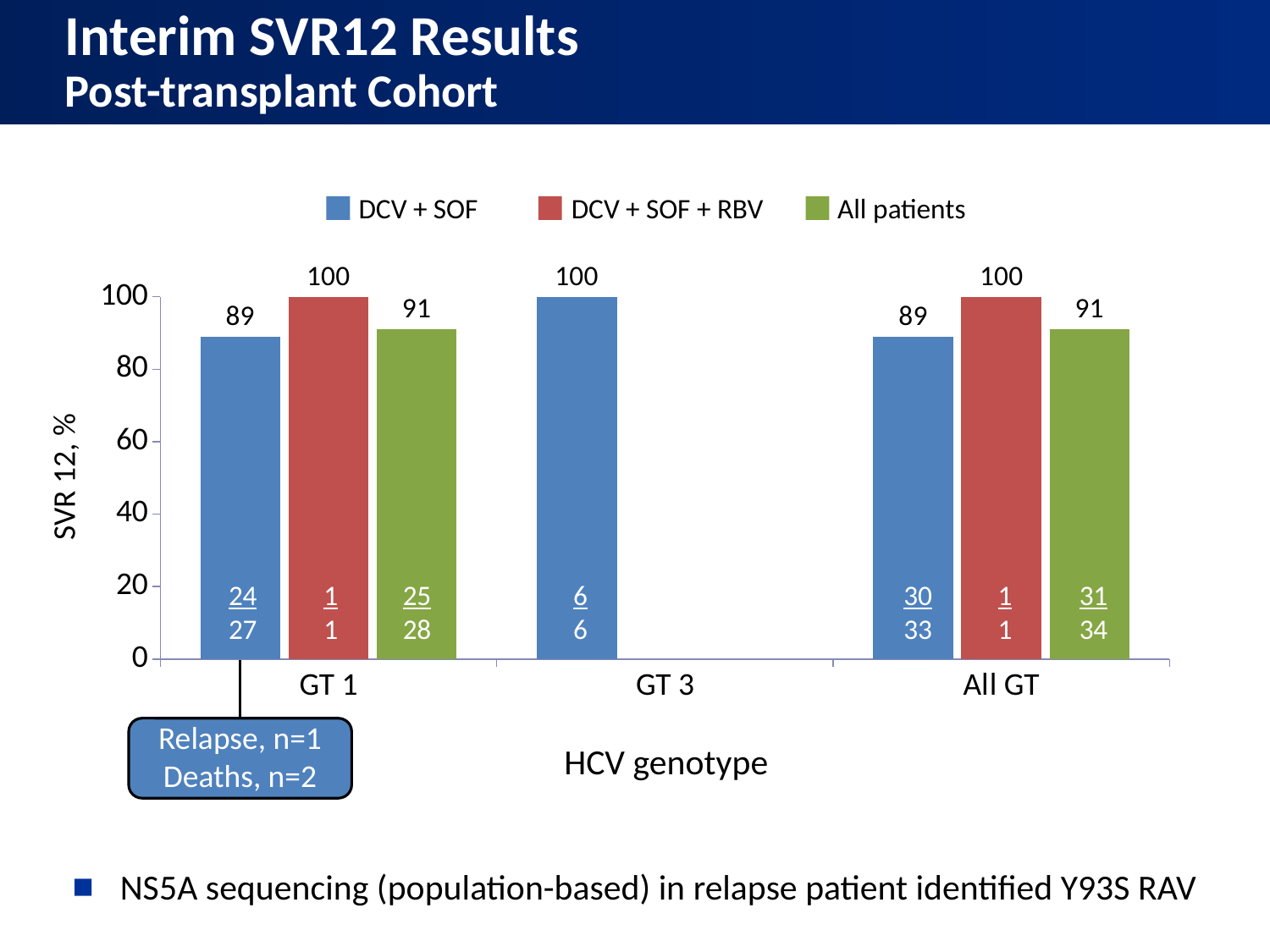
What is the difference between the All patients and DCV + SOF values in GT 1? 2 What kind of chart is shown on the slide? Bar chart Which series has the lowest SVR12 value in All GT? DCV + SOF Which is larger in All GT: the DCV + SOF value or the All patients value? All patients What is the SVR12 value for DCV + SOF in GT 3? 100 How many genotype categories are shown on the x axis? 3 What is the SVR12 value for DCV + SOF + RBV in GT 1? 100 What is the label of the y axis? SVR 12, % Which series has the highest SVR12 value in GT 1? DCV + SOF + RBV What is the SVR12 value for DCV + SOF in GT 1? 89 How many series does the legend list? 3 What is the SVR12 value for All patients in All GT? 91